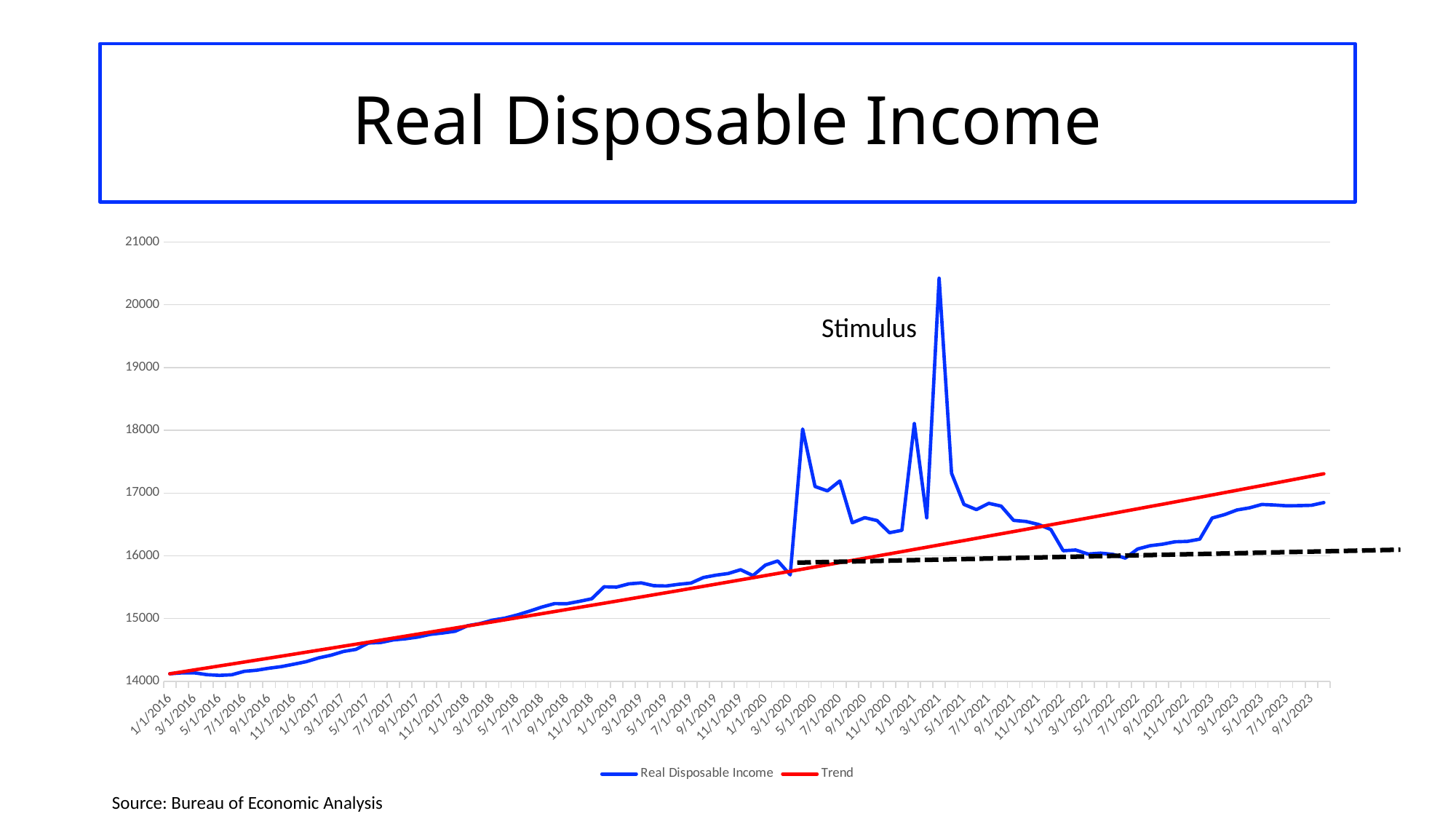
Is the value of the Trend series at 9/1/2023 greater or less than 17000? greater Is the peak value of Real Disposable Income greater or less than 20000? greater What annotation text is placed near the large spike in the chart? Stimulus At which date does the Real Disposable Income series reach its highest value? 3/1/2021 At 9/1/2023, which series has the higher value, Real Disposable Income or Trend? Trend How many series does the legend list? 2 Does the Trend series rise or fall from 1/1/2016 to 9/1/2023? rise Is the value of Real Disposable Income at 1/1/2016 greater or less than 15000? less What kind of chart is shown on the slide? Line chart At 1/1/2019, which series has the higher value, Real Disposable Income or Trend? Real Disposable Income What is the title of the chart? Real Disposable Income